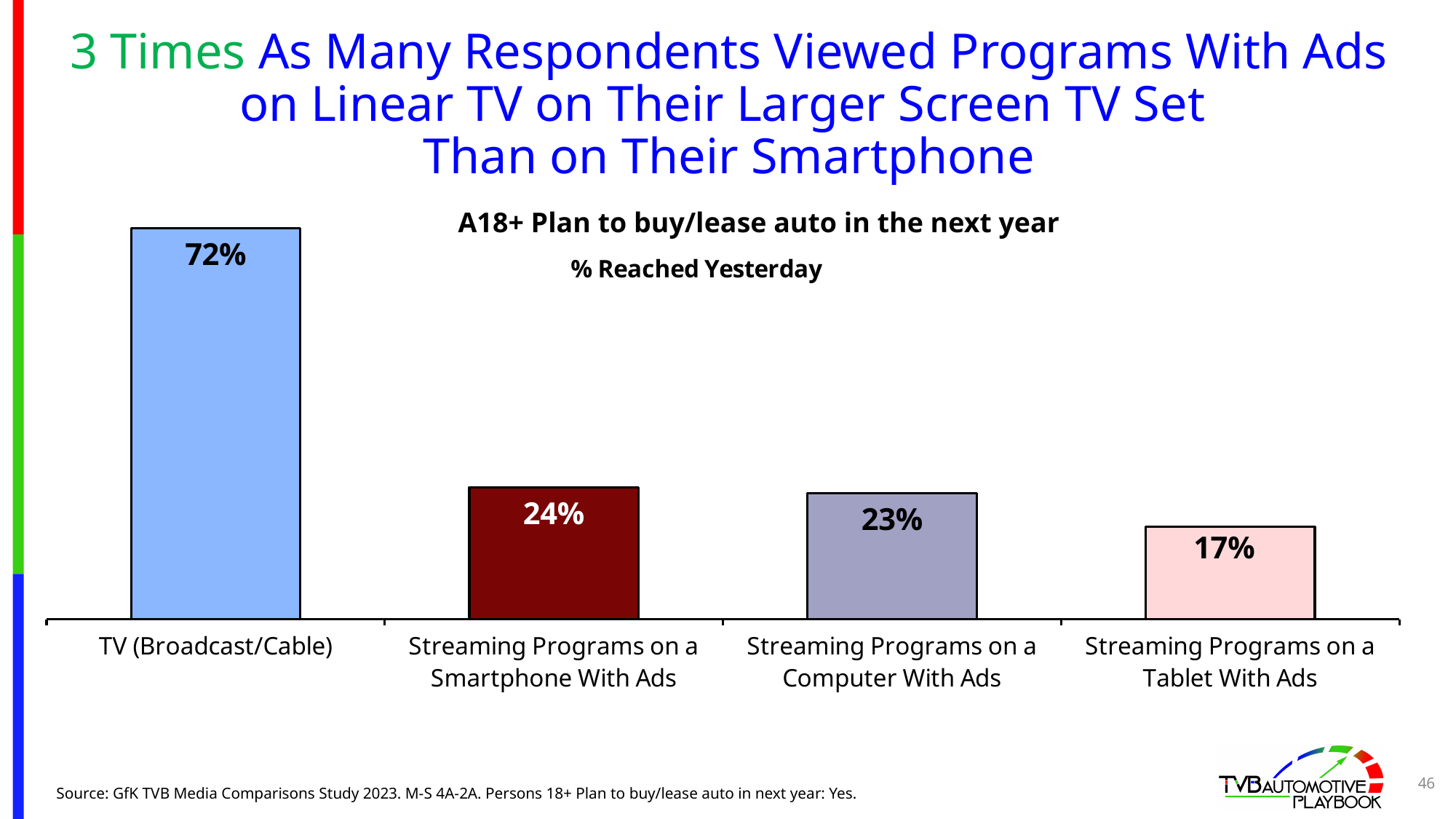
What is the difference between the value for Streaming Programs on a Computer With Ads and the value for Streaming Programs on a Tablet With Ads? 6% How many categories are shown in the chart? 4 What is the value for Streaming Programs on a Computer With Ads? 23% Which category has the highest value? TV (Broadcast/Cable) What is the value for Streaming Programs on a Tablet With Ads? 17% Which is larger: the value for Streaming Programs on a Smartphone With Ads or the value for Streaming Programs on a Tablet With Ads? Streaming Programs on a Smartphone With Ads What kind of chart is shown on the slide? Bar chart What is the difference between the value for TV (Broadcast/Cable) and the value for Streaming Programs on a Smartphone With Ads? 48% Which category has the lowest value? Streaming Programs on a Tablet With Ads What is the value for Streaming Programs on a Smartphone With Ads? 24% What is the title of the chart? A18+ Plan to buy/lease auto in the next year % Reached Yesterday What is the value for TV (Broadcast/Cable)? 72%